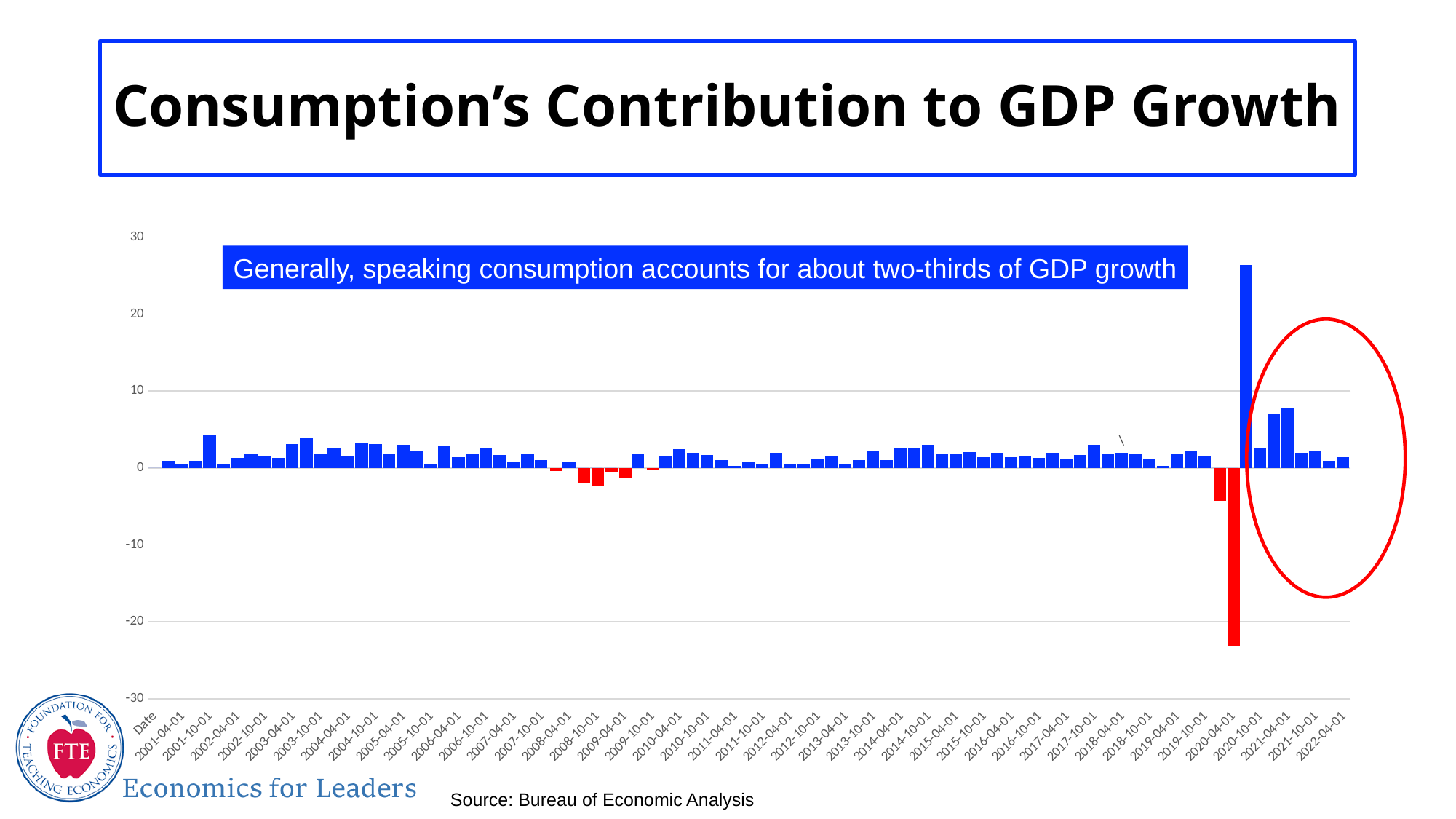
Which is larger, the value of the bar at 2020-04-01 or the bar at 2020-10-01? 2020-10-01 Is the value of the bar at 2021-04-01 greater or less than 10? less What source is cited for the chart data? Bureau of Economic Analysis What is the title of the slide's chart? Consumption's Contribution to GDP Growth Is the value of the bar at 2020-04-01 greater or less than -10? less Is the value of the tallest blue bar greater or less than 20? greater What is the highest value shown on the vertical axis? 30 Which is larger, the value of the bar at 2021-04-01 or the bar at 2021-10-01? 2021-04-01 What kind of chart is shown on the slide? bar chart Around which x-axis date does the lowest (most negative) bar occur? 2020-04-01